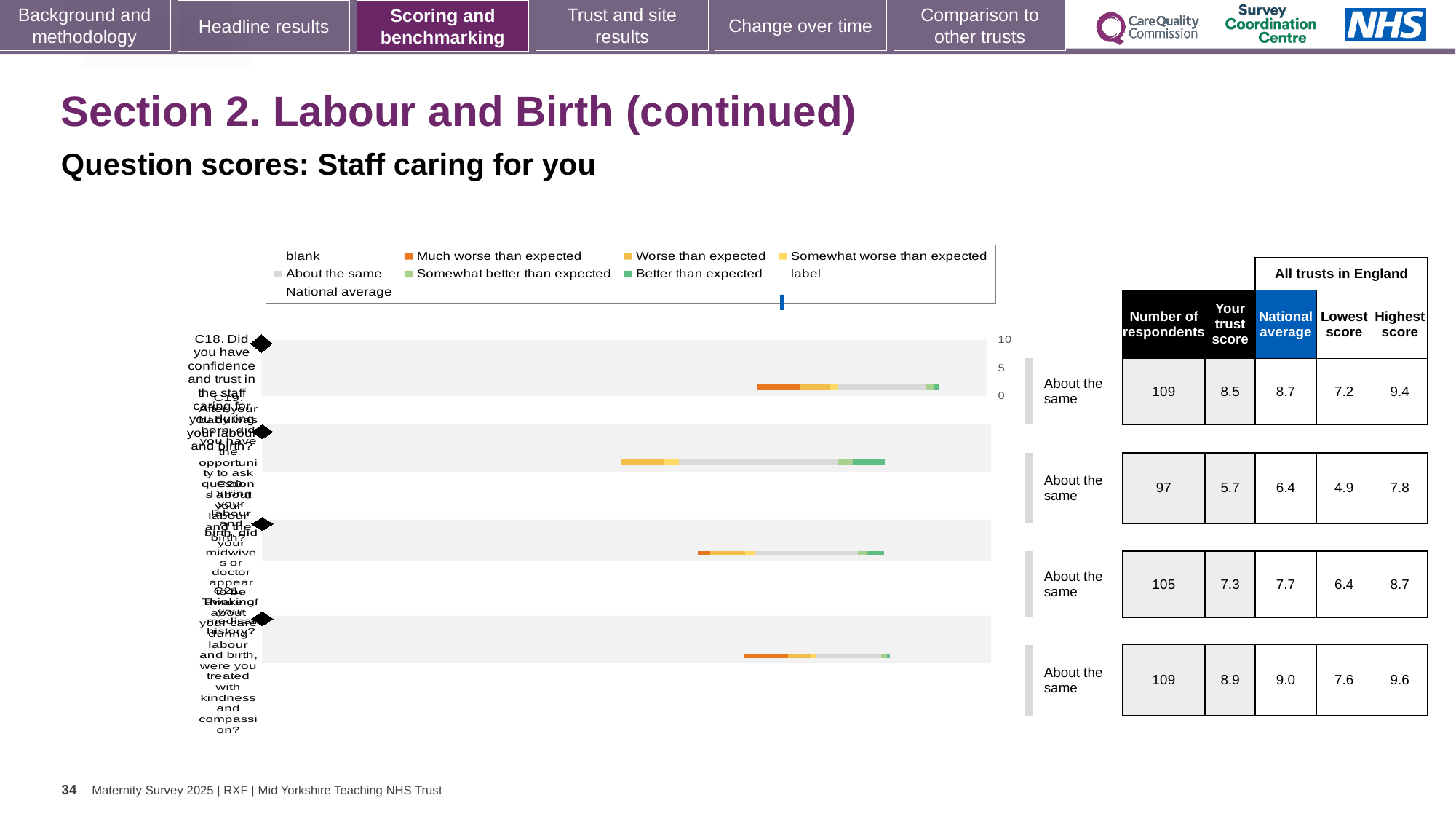
For question C20, which is larger: the trust score or the national average? National average What is the lowest score across all trusts in England shown for question C19? 4.9 What is the trust score shown for question C18 (confidence and trust in the staff caring for you)? 8.5 What kind of chart is used to show the question scores on this slide? bar chart Which question has the lowest trust score on this slide? C19 What is the highest score across all trusts in England shown for question C21? 9.6 How many questions (rows) are plotted in the chart? 4 What is the national average shown for question C19? 6.4 What is the difference between the national average and the trust score for question C18? 0.2 What benchmark category is shown for all four questions on this slide? About the same How many respondents are shown for question C20? 105 Which question has the highest trust score on this slide? C21